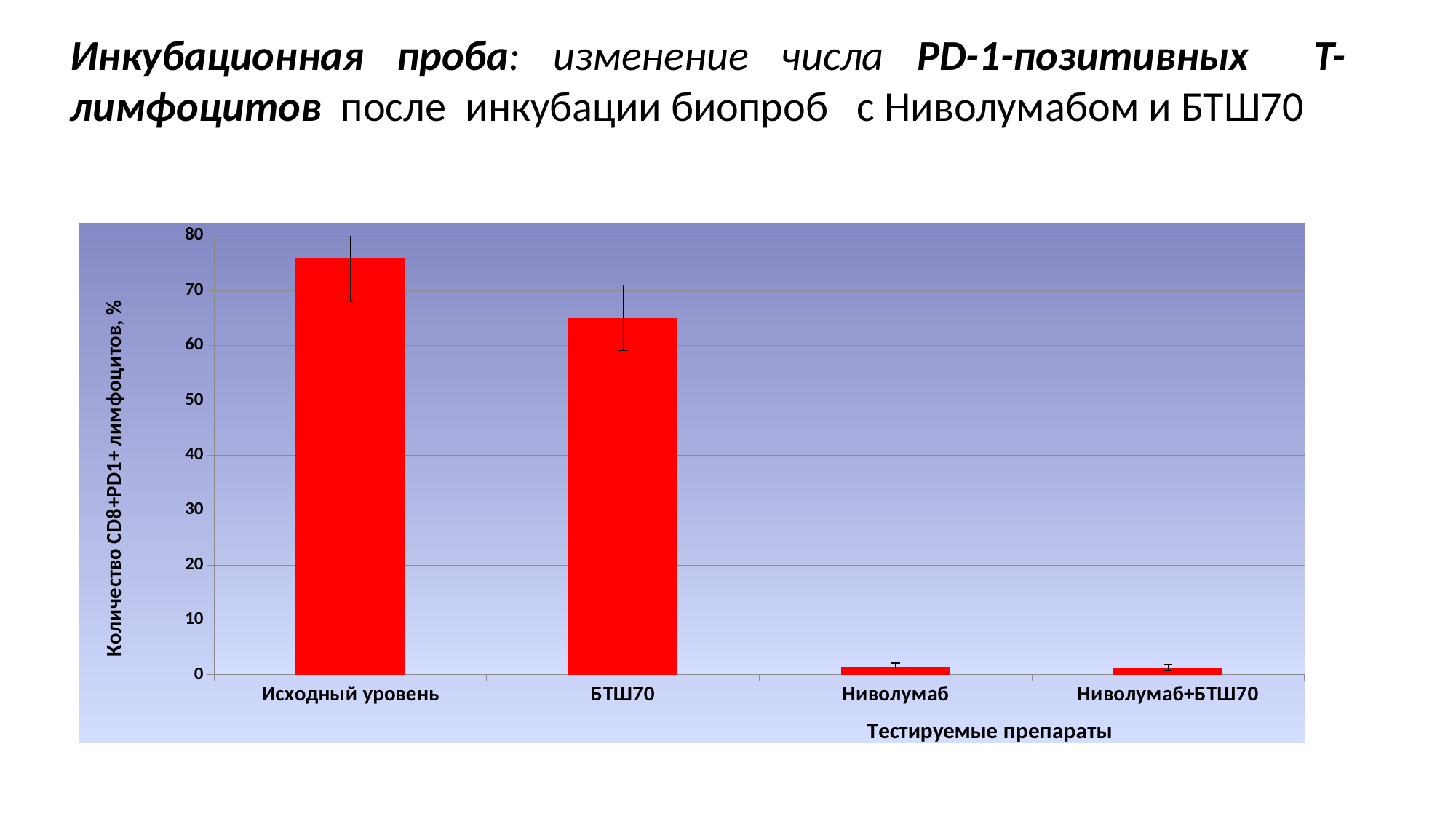
Is the value for Ниволумаб greater or less than 10? less Do the values rise or fall from left to right along the x axis? fall How many categories are shown on the x axis of the chart? 4 What is the title of the x axis of the chart? Тестируемые препараты Is the value for БТШ70 greater or less than 70? less What kind of chart is shown on the slide? bar chart Is the value for БТШ70 greater or less than 60? greater Which is larger, the value for БТШ70 or the value for Ниволумаб? БТШ70 Which category has the highest value in the chart? Исходный уровень Which is larger, the value for Исходный уровень or the value for БТШ70? Исходный уровень